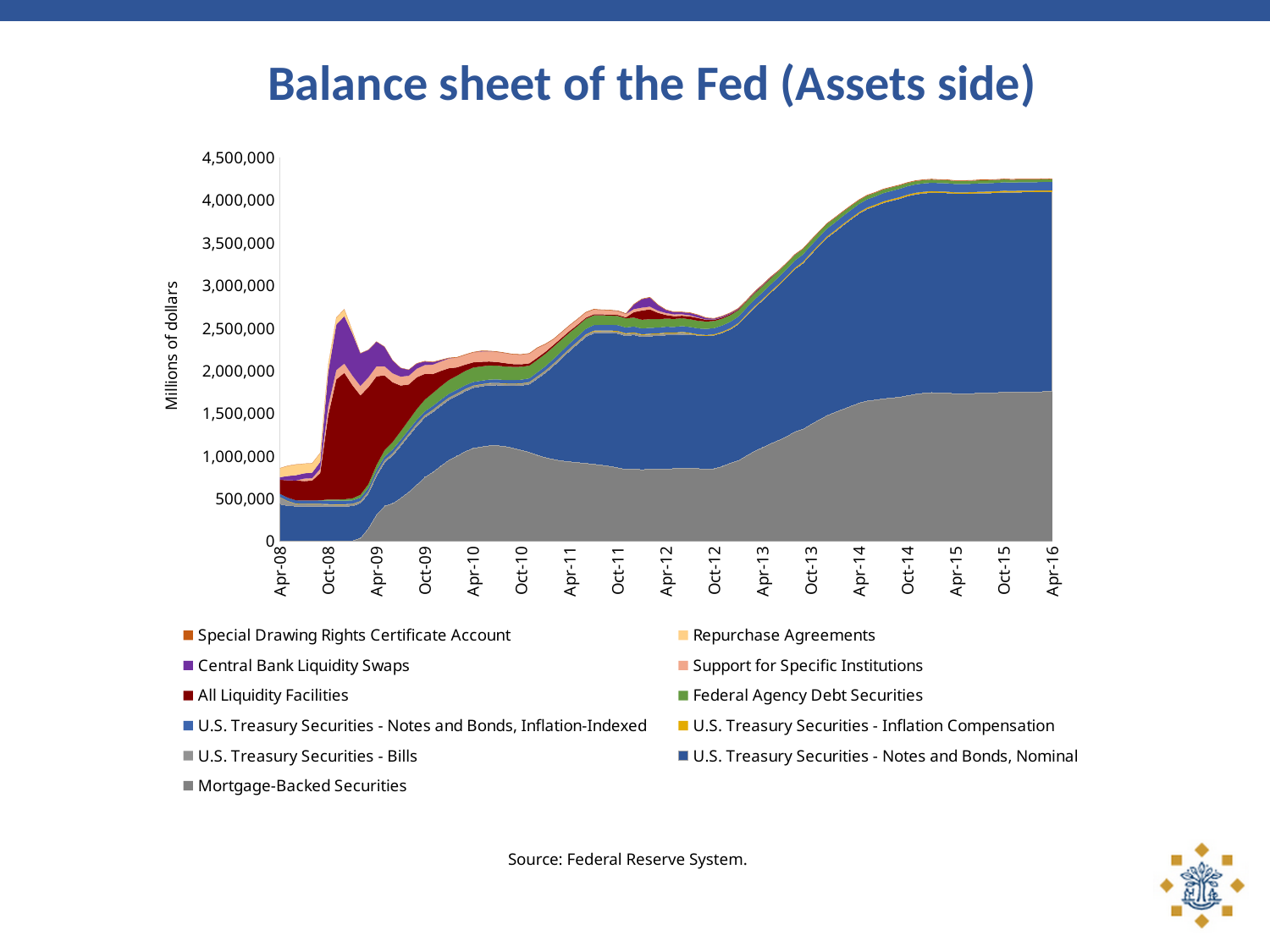
At which x-axis date is the total of all assets lowest? Apr-08 What is the title of the chart? Balance sheet of the Fed (Assets side) Is the total value of all assets at Apr-08 greater or less than 1,000,000? less Is the total value of all assets at Oct-13 greater or less than 3,000,000? greater What unit is shown on the vertical axis label? Millions of dollars Does the total of the Fed's assets generally rise or fall from Apr-08 to Apr-16? rise Is the total value of all assets at Apr-16 greater or less than 4,000,000? greater What kind of chart is shown on the slide? Stacked area chart How many date labels are shown along the x axis? 17 Which is larger, the total assets at Apr-16 or at Apr-08? Apr-16 How many series does the legend list? 11